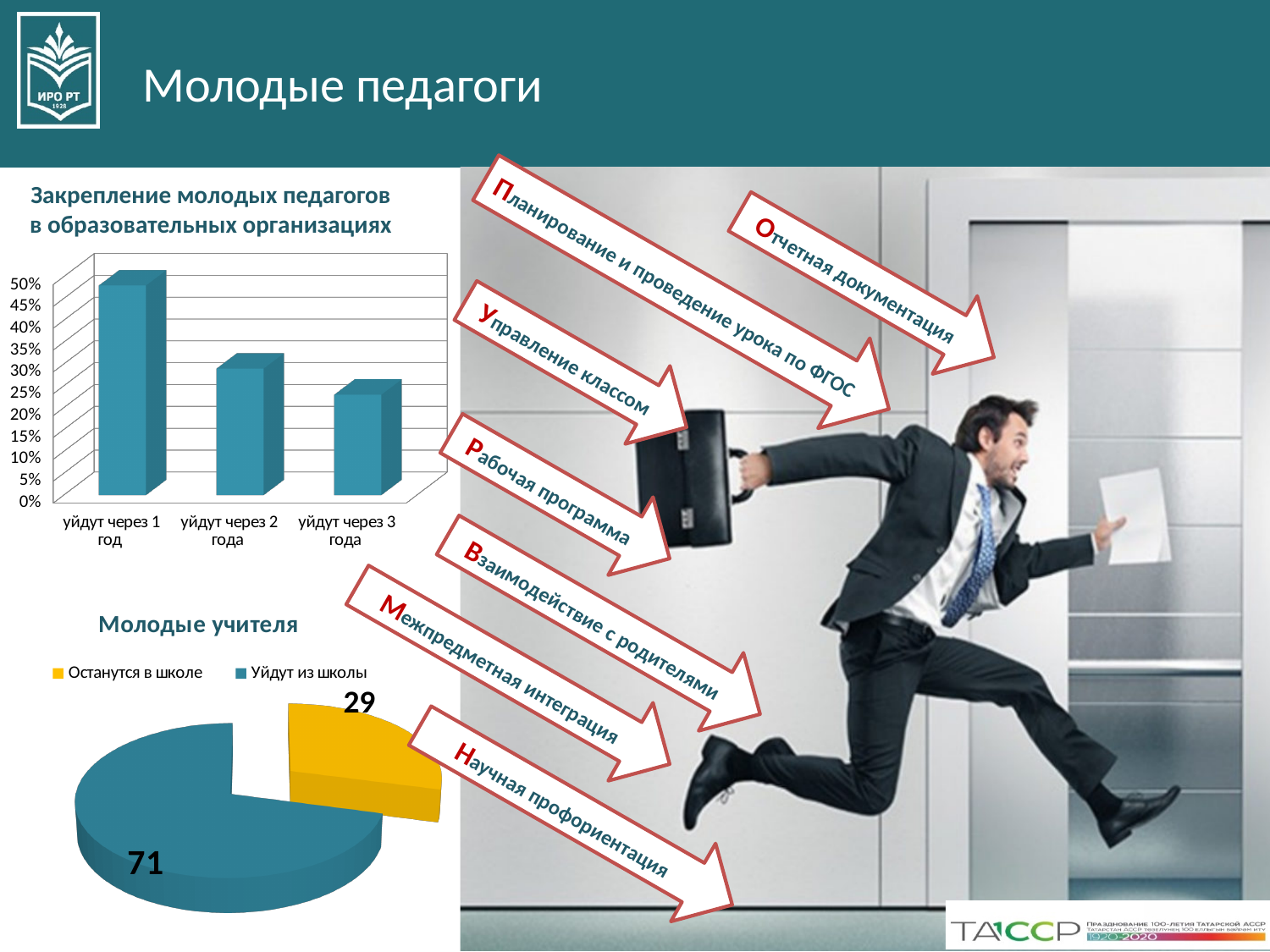
How many categories does the bar chart "Закрепление молодых педагогов в образовательных организациях" show? 3 In the pie chart "Молодые учителя", what is the value for "Останутся в школе"? 29 In the pie chart "Молодые учителя", what is the value for "Уйдут из школы"? 71 What kind of chart is the chart titled "Закрепление молодых педагогов в образовательных организациях"? bar chart In the pie chart "Молодые учителя", what is the difference between the values for "Уйдут из школы" and "Останутся в школе"? 42 In the bar chart "Закрепление молодых педагогов в образовательных организациях", which is larger: the value for "уйдут через 2 года" or for "уйдут через 3 года"? уйдут через 2 года In the bar chart "Закрепление молодых педагогов в образовательных организациях", do the values rise or fall from left to right? fall What kind of chart is the chart titled "Молодые учителя"? pie chart In the bar chart "Закрепление молодых педагогов в образовательных организациях", is the value for "уйдут через 1 год" greater or less than 40%? greater In the bar chart "Закрепление молодых педагогов в образовательных организациях", is the value for "уйдут через 3 года" greater or less than 30%? less In the bar chart "Закрепление молодых педагогов в образовательных организациях", which category has the highest value? уйдут через 1 год In the bar chart "Закрепление молодых педагогов в образовательных организациях", which category has the lowest value? уйдут через 3 года